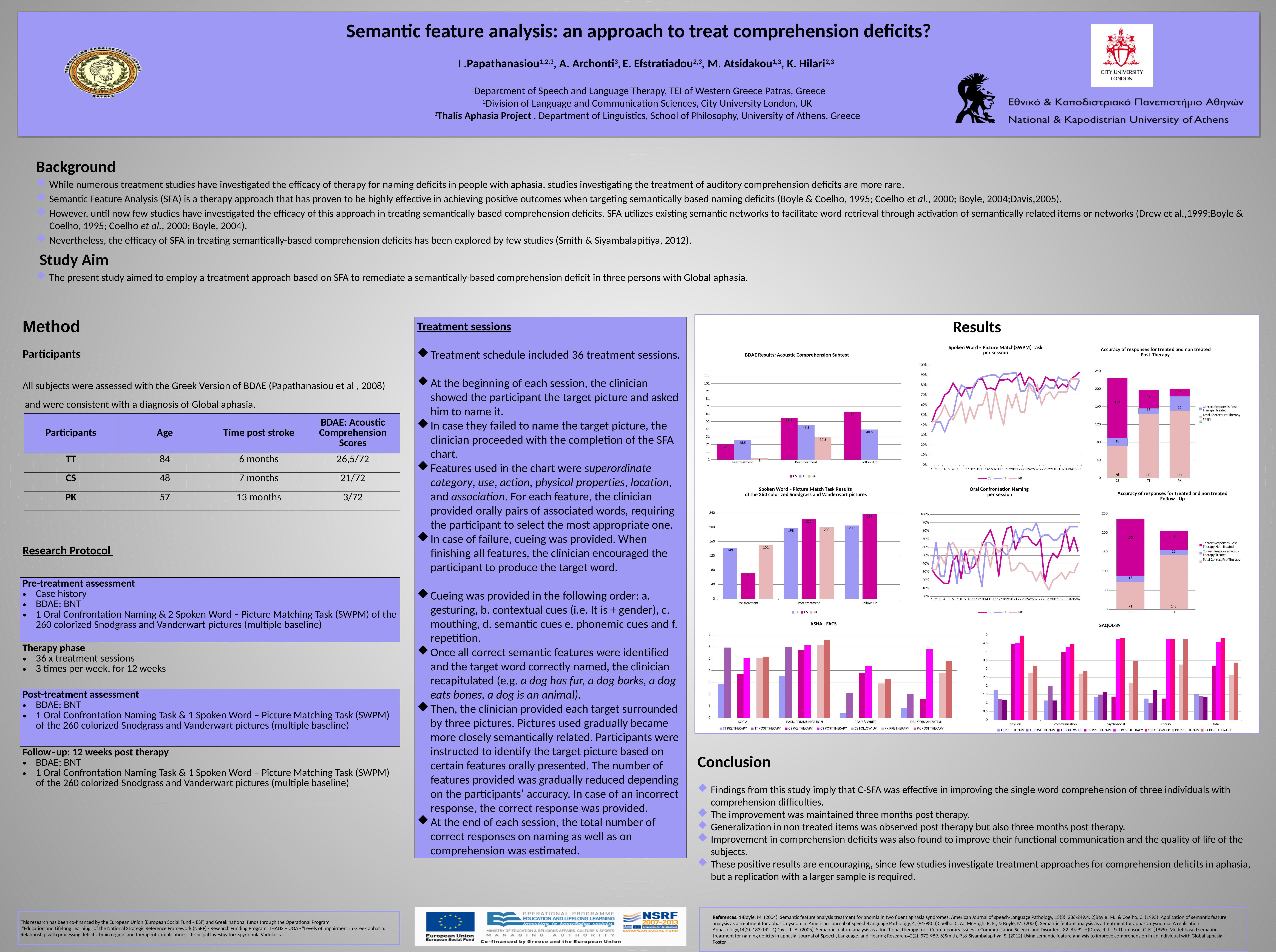
In the 'Spoken Word – Picture Match Task Results of the 260 colorized Snodgrass and Vanderwart pictures' chart, what is the Pre-treatment value for CS? 71 In the 'BDAE Results: Acoustic Comprehension Subtest' chart, what is the Post-treatment value for PK? 30.5 In the 'Spoken Word – Picture Match Task Results of the 260 colorized Snodgrass and Vanderwart pictures' chart, what is the difference between the Follow-Up and Pre-treatment values for CS? 166 In the 'Accuracy of responses for treated and non treated Follow - Up' chart, what is the total of the stacked bar for TT? 205 In the 'BDAE Results: Acoustic Comprehension Subtest' chart, which participant has the highest Post-treatment value? CS In the 'BDAE Results: Acoustic Comprehension Subtest' chart, what is the difference between the Post-treatment values for CS and TT? 9 How many series does the legend of the 'BDAE Results: Acoustic Comprehension Subtest' chart list? 3 In the 'Spoken Word – Picture Match Task Results of the 260 colorized Snodgrass and Vanderwart pictures' chart, what is the Post-treatment value for PK? 200 What kind of chart is the 'Oral Confrontation Naming per session' chart? line chart In the 'Spoken Word – Picture Match Task Results of the 260 colorized Snodgrass and Vanderwart pictures' chart, which participant has the highest Post-treatment value? CS In the 'BDAE Results: Acoustic Comprehension Subtest' chart, what is the Pre-treatment value for CS? 21